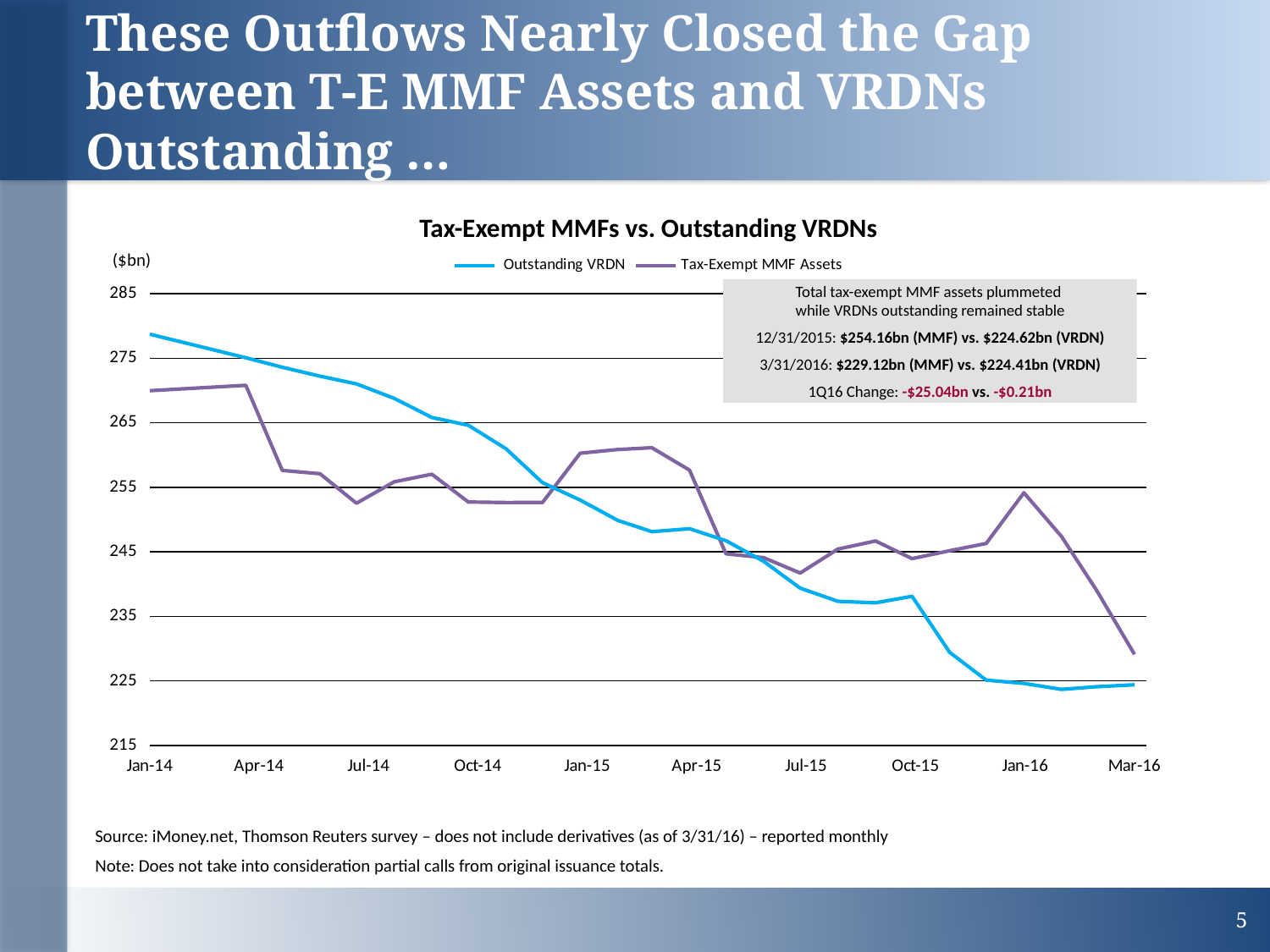
Is the value of Outstanding VRDN at Jan-14 greater or less than 275? greater Using the values in the text box, what was the gap between MMF assets and VRDNs outstanding on 3/31/2016? $4.71bn According to the text box on the chart, what was the value of VRDNs outstanding on 3/31/2016? $224.41bn How many series does the legend of the chart list? 2 Is the value of Tax-Exempt MMF Assets at Mar-16 greater or less than 235? less At Jan-16, which series has the higher value, Outstanding VRDN or Tax-Exempt MMF Assets? Tax-Exempt MMF Assets What is the title of the chart? Tax-Exempt MMFs vs. Outstanding VRDNs Using the values in the text box, what was the gap between MMF assets and VRDNs outstanding on 12/31/2015? $29.54bn Does the Outstanding VRDN line generally rise or fall from Jan-14 to Mar-16? fall According to the text box on the chart, what were total tax-exempt MMF assets on 12/31/2015? $254.16bn What was the 1Q16 change in tax-exempt MMF assets shown in the text box? -$25.04bn What kind of chart is shown on the slide? line chart